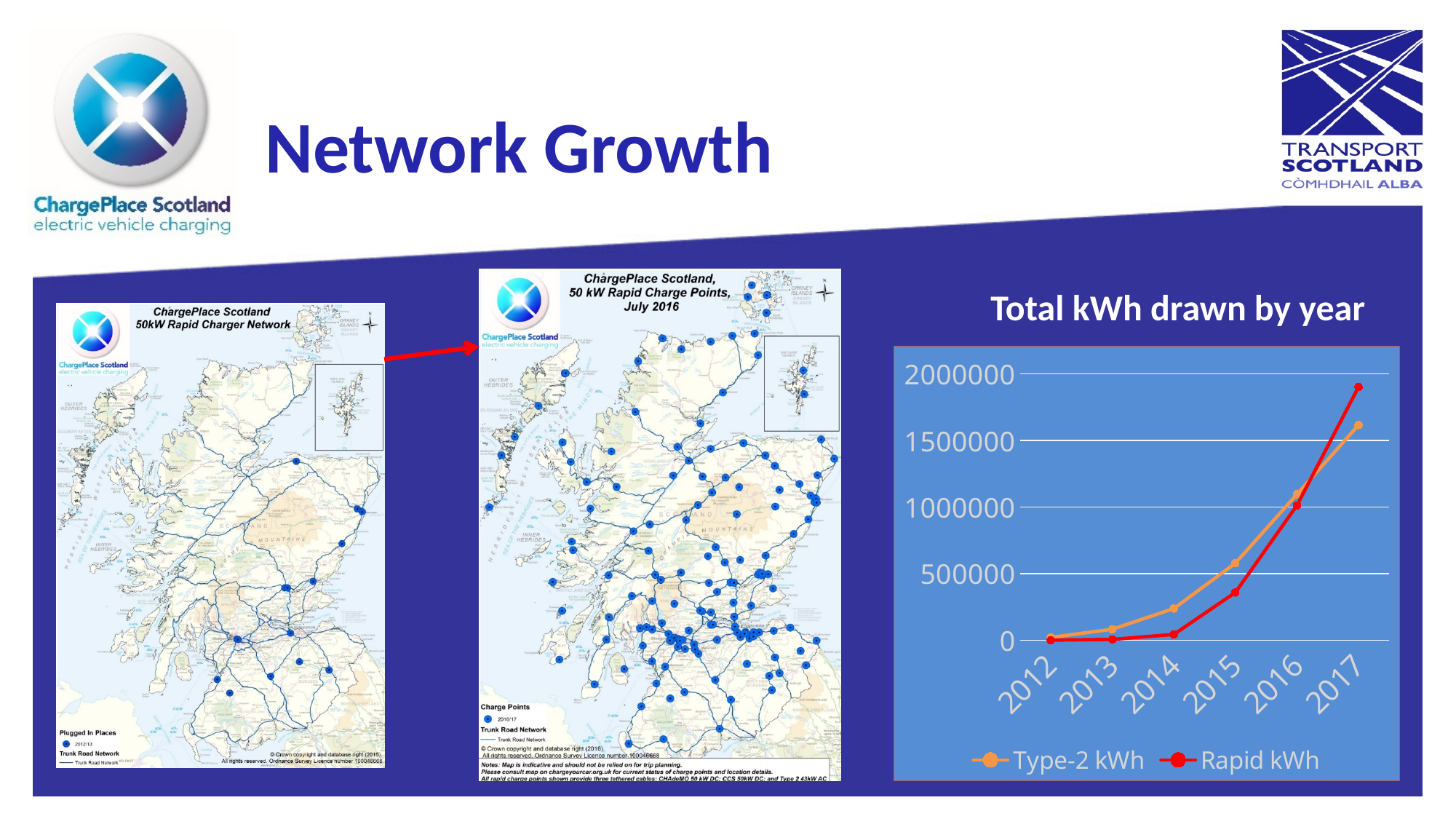
What is the title of the chart on the right of the slide? Total kWh drawn by year In the 'Total kWh drawn by year' chart, is the Rapid kWh value for 2015 greater or less than 500000? less What kind of chart is the 'Total kWh drawn by year' chart? line chart How many years are shown on the x axis of the 'Total kWh drawn by year' chart? 6 In the 'Total kWh drawn by year' chart, what colour is the Rapid kWh line? red In the 'Total kWh drawn by year' chart, is the Rapid kWh value for 2017 greater or less than 1500000? greater In the 'Total kWh drawn by year' chart, which series is higher in 2015, Type-2 kWh or Rapid kWh? Type-2 kWh In the 'Total kWh drawn by year' chart, which year has the lowest Type-2 kWh value? 2012 In the 'Total kWh drawn by year' chart, which series is higher in 2017, Type-2 kWh or Rapid kWh? Rapid kWh In the 'Total kWh drawn by year' chart, do the Type-2 kWh values rise or fall from 2012 to 2017? rise How many series does the legend of the 'Total kWh drawn by year' chart list? 2 In the 'Total kWh drawn by year' chart, which year has the highest Rapid kWh value? 2017